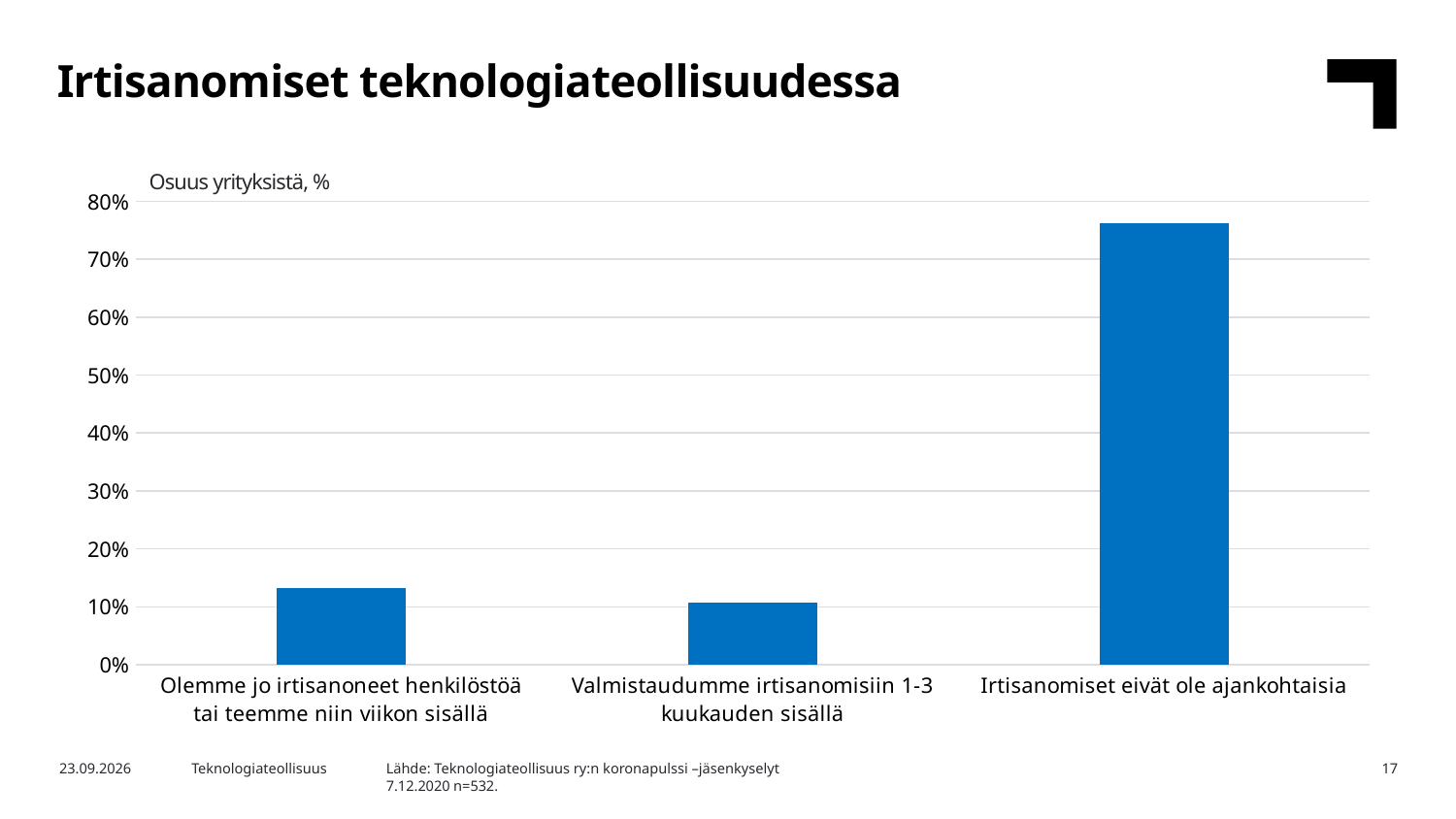
Which category has the highest value in the chart? Irtisanomiset eivät ole ajankohtaisia Which is larger: the value for 'Olemme jo irtisanoneet henkilöstöä tai teemme niin viikon sisällä' or the value for 'Valmistaudumme irtisanomisiin 1-3 kuukauden sisällä'? Olemme jo irtisanoneet henkilöstöä tai teemme niin viikon sisällä Which category has the lowest value in the chart? Valmistaudumme irtisanomisiin 1-3 kuukauden sisällä Is the value for 'Irtisanomiset eivät ole ajankohtaisia' greater or less than 70%? greater What kind of chart is shown on the slide? Bar chart How many categories are shown on the x axis of the chart? 3 Is the value for 'Valmistaudumme irtisanomisiin 1-3 kuukauden sisällä' greater or less than 20%? less What is the title of the slide containing the chart? Irtisanomiset teknologiateollisuudessa Is the value for 'Olemme jo irtisanoneet henkilöstöä tai teemme niin viikon sisällä' greater or less than 20%? less What label is shown above the vertical axis of the chart? Osuus yrityksistä, %